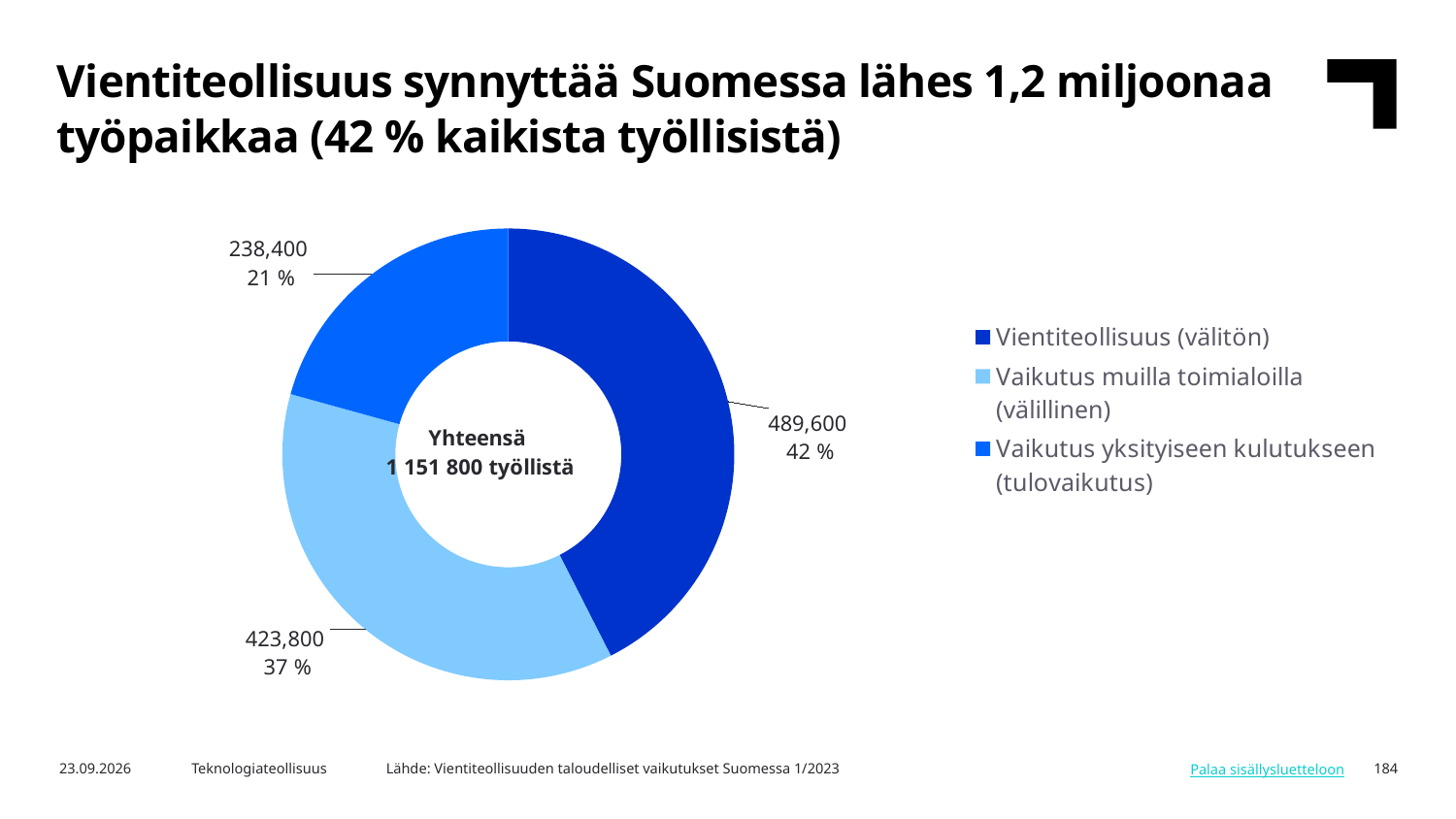
What is the value for Vaikutus muilla toimialoilla (välillinen)? 423,800 What share of the donut does Vaikutus yksityiseen kulutukseen (tulovaikutus) represent? 21 % What total is shown in the centre of the donut chart? 1 151 800 työllistä What share of the donut does Vientiteollisuus (välitön) represent? 42 % What is the difference between the values for Vientiteollisuus (välitön) and Vaikutus muilla toimialoilla (välillinen)? 65,800 How many slices does the donut chart have? 3 How many entries does the legend list? 3 Which category has the largest slice? Vientiteollisuus (välitön) Which category has the smallest slice? Vaikutus yksityiseen kulutukseen (tulovaikutus) What kind of chart is shown on the slide? Donut (pie) chart What is the value for Vientiteollisuus (välitön)? 489,600 What is the value for Vaikutus yksityiseen kulutukseen (tulovaikutus)? 238,400